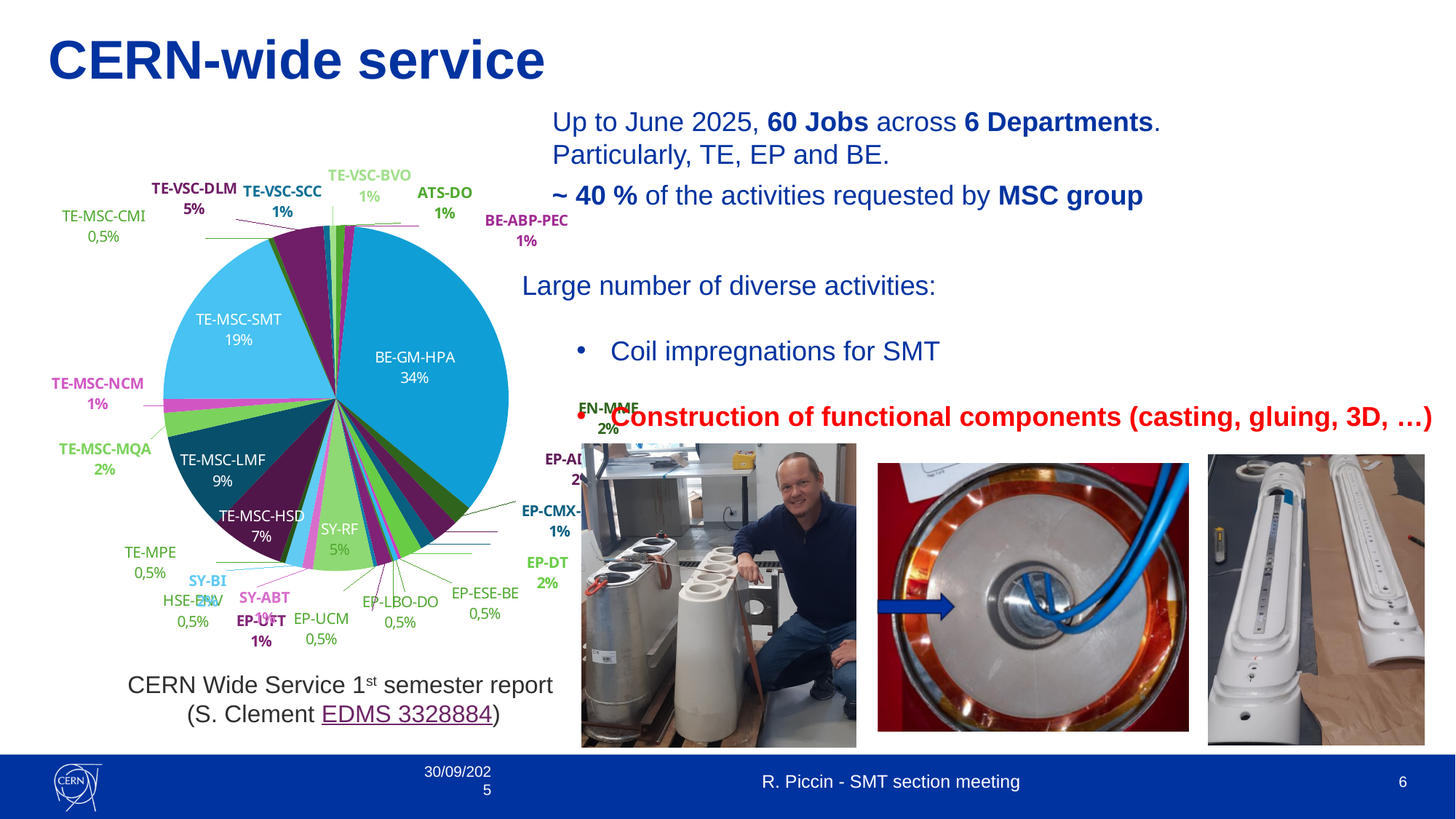
What percentage is shown for EP-ESE-BE? 0,5% What percentage is shown for TE-MSC-SMT? 19% What percentage is shown for TE-MSC-MQA? 2% What is the difference in percentage points between BE-GM-HPA and TE-MSC-SMT? 15 What share of the pie does BE-GM-HPA represent? 34% What percentage is shown for TE-MSC-HSD? 7% What percentage is shown for TE-MSC-LMF? 9% Which has a larger share, TE-MSC-LMF or TE-MSC-HSD? TE-MSC-LMF What type of chart is shown on the slide? pie chart What percentage is shown for SY-RF? 5% Which category has the largest slice of the pie? BE-GM-HPA What percentage is shown for TE-VSC-DLM? 5%